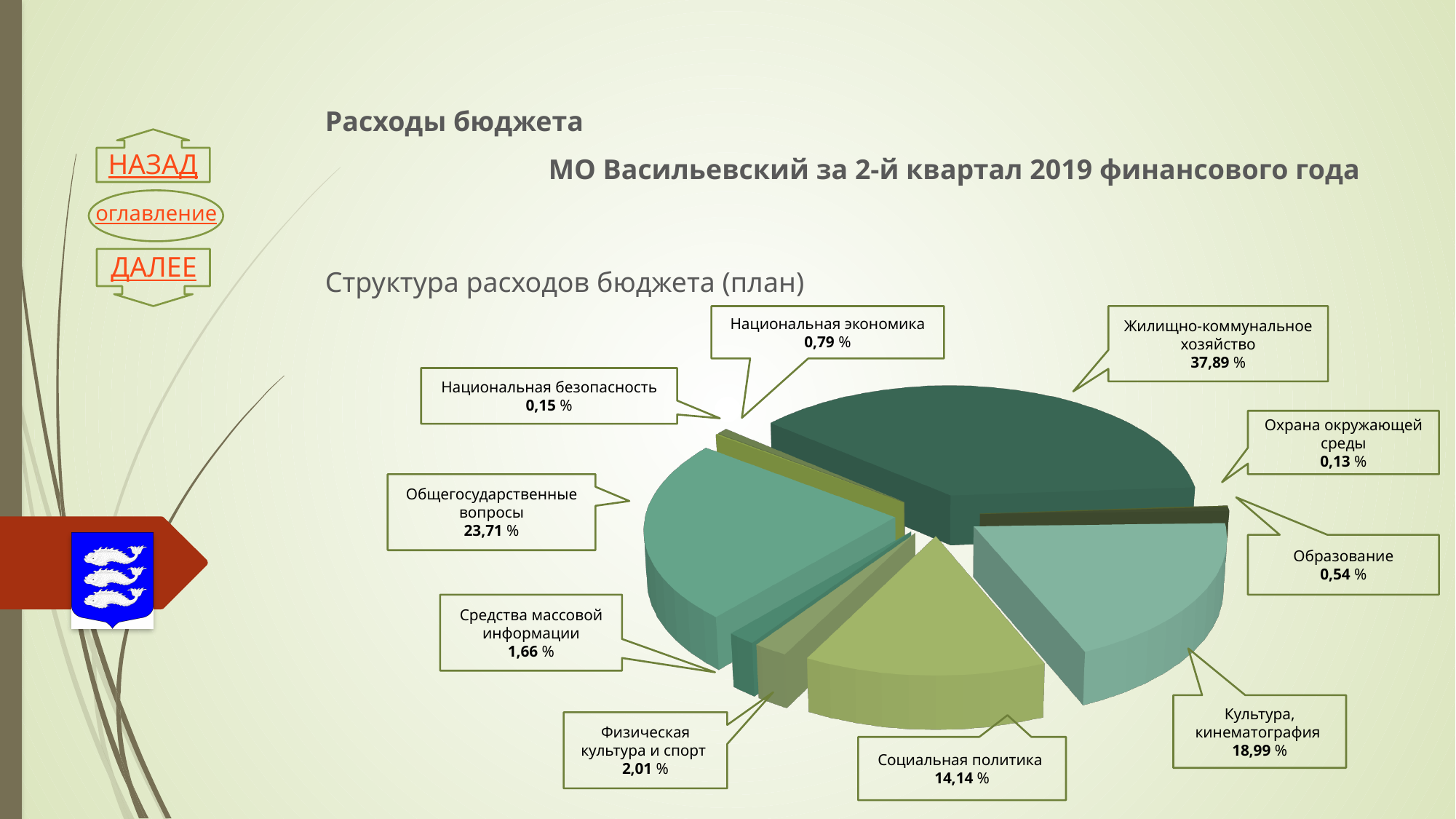
What share of the pie does Жилищно-коммунальное хозяйство have? 37,89 % How many categories are shown in the pie chart? 10 What is the value shown for Общегосударственные вопросы? 23,71 % What kind of chart is shown on the slide? Pie chart What is the combined share of Образование and Национальная безопасность? 0,69 % Which category has the largest share of the pie? Жилищно-коммунальное хозяйство What is the difference between the shares of Общегосударственные вопросы and Культура, кинематография? 4,72 % Which category has the smallest share of the pie? Охрана окружающей среды What is the value shown for Физическая культура и спорт? 2,01 % Which is larger: the share of Средства массовой информации or the share of Национальная экономика? Средства массовой информации What is the value shown for Социальная политика? 14,14 % What is the title of the chart? Структура расходов бюджета (план)